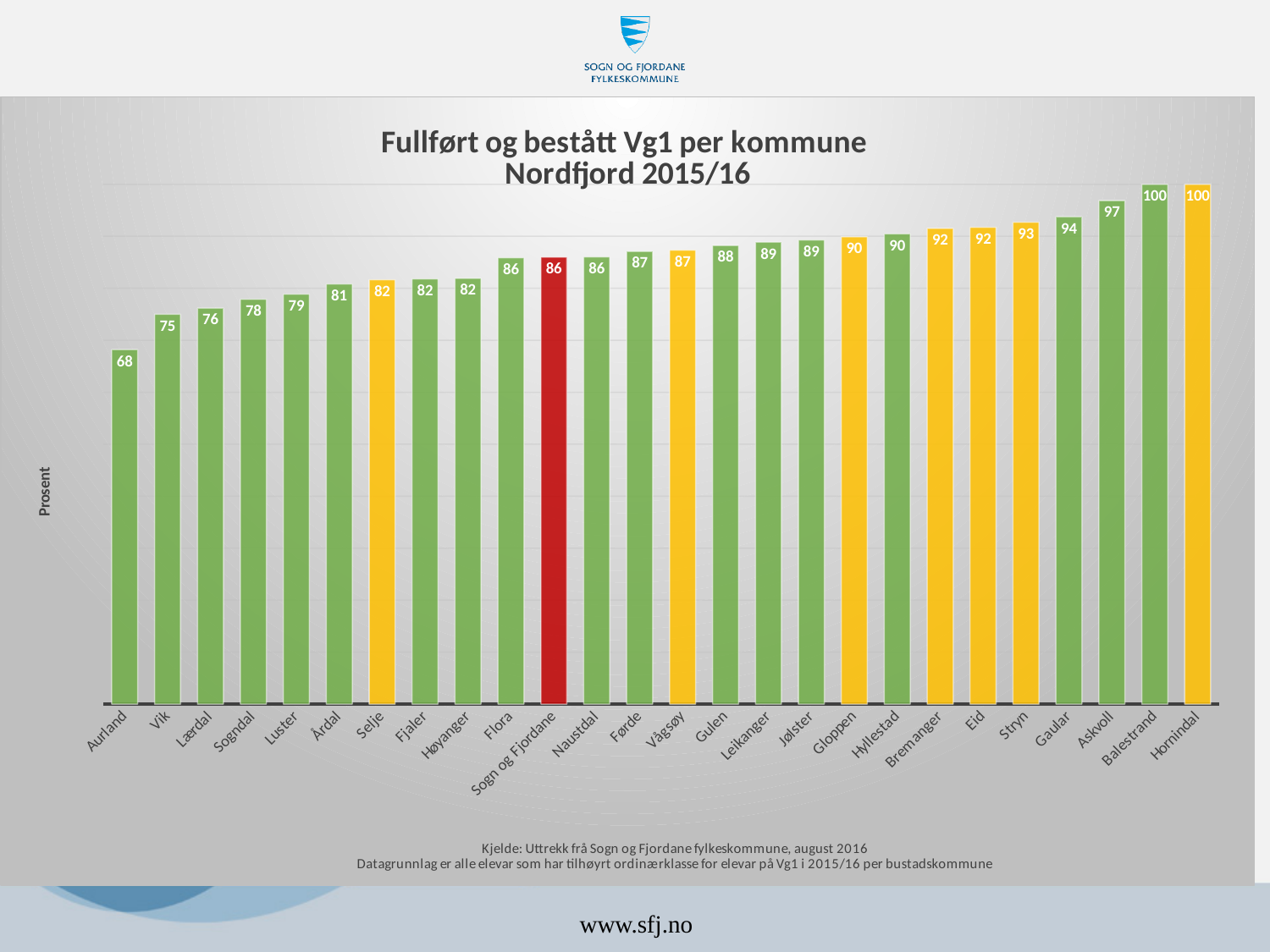
How many bars are shown in the chart? 26 Which kommune has the lowest value? Aurland What kind of chart is shown on the slide? Bar chart Which has a higher value, Gloppen or Vågsøy? Gloppen What is the value for Aurland? 68 What is the value for Stryn? 93 Which bar is coloured red? Sogn og Fjordane What is the value for Eid? 92 What is the difference between the values for Hornindal and Aurland? 32 What is the difference between the values for Askvoll and Gaular? 3 What is the value for Sogn og Fjordane? 86 Do the values rise or fall from left to right along the x axis? Rise